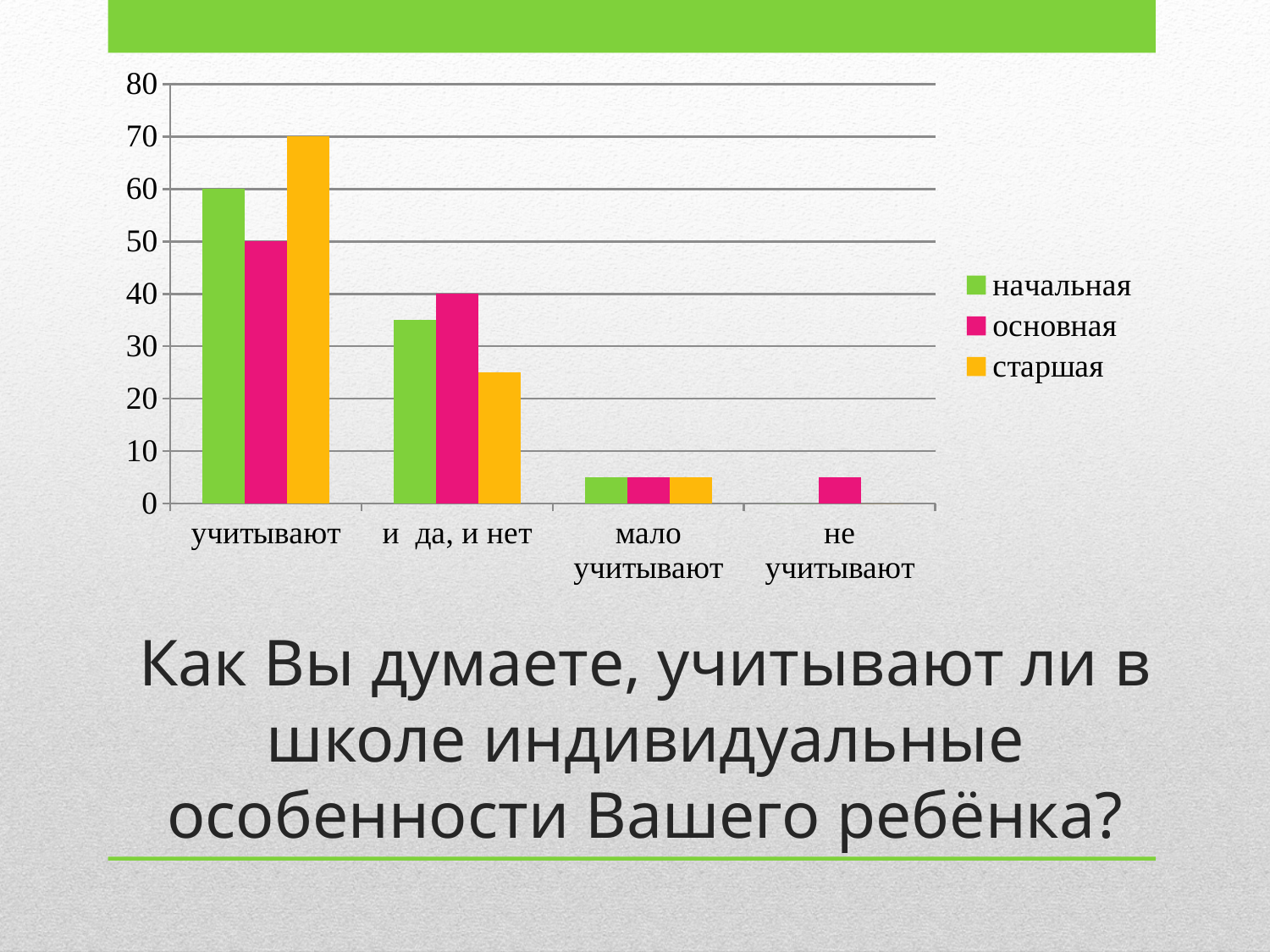
Which series has the lowest value in the category и да, и нет? старшая What is the value for основная in the category учитывают? 50 Which series is the only one with a visible bar in the category не учитывают? основная What is the value for старшая in the category учитывают? 70 What kind of chart is shown on the slide? bar chart How many categories are shown on the x axis? 4 What is the difference between the старшая and основная values in the category учитывают? 20 Which series has the highest value in the category учитывают? старшая Is the value for начальная in the category и да, и нет greater or less than 30? greater What is the value for основная in the category и да, и нет? 40 What is the value for начальная in the category учитывают? 60 How many series does the legend list? 3